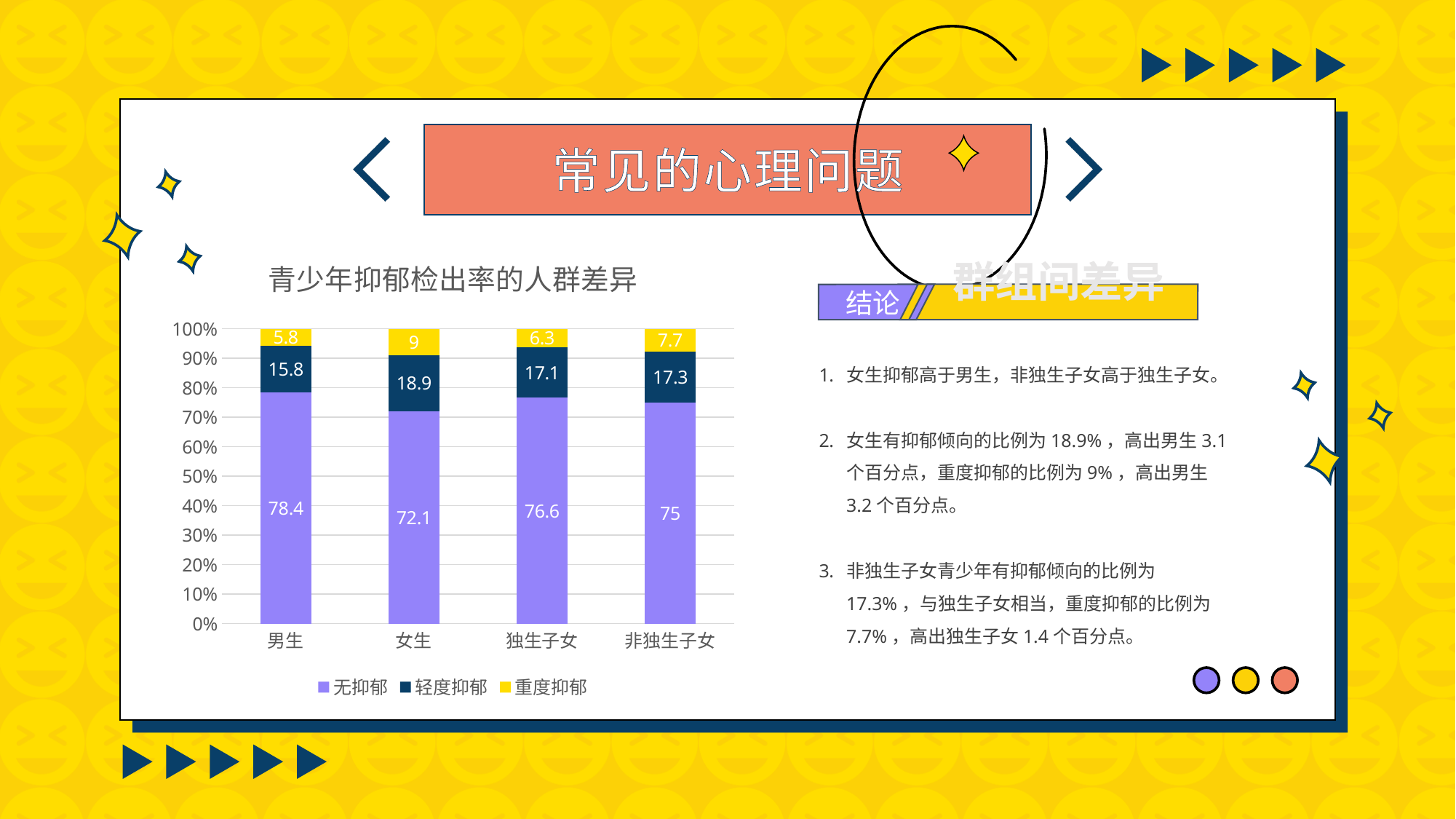
What is the value of 重度抑郁 for 非独生子女? 7.7 Which category has the highest 重度抑郁 value? 女生 Which category has the lowest 无抑郁 value? 女生 Which is larger, the 无抑郁 value for 独生子女 or for 非独生子女? 独生子女 What is the title of the chart? 青少年抑郁检出率的人群差异 How many series does the chart legend list? 3 What is the value of 轻度抑郁 for 女生? 18.9 What is the total of the stacked bar for 男生? 100 What is the difference between the 轻度抑郁 values for 女生 and 男生? 3.1 How many categories are shown on the x axis of the chart? 4 What type of chart is shown on the slide? stacked bar chart What is the value of 无抑郁 for 男生? 78.4